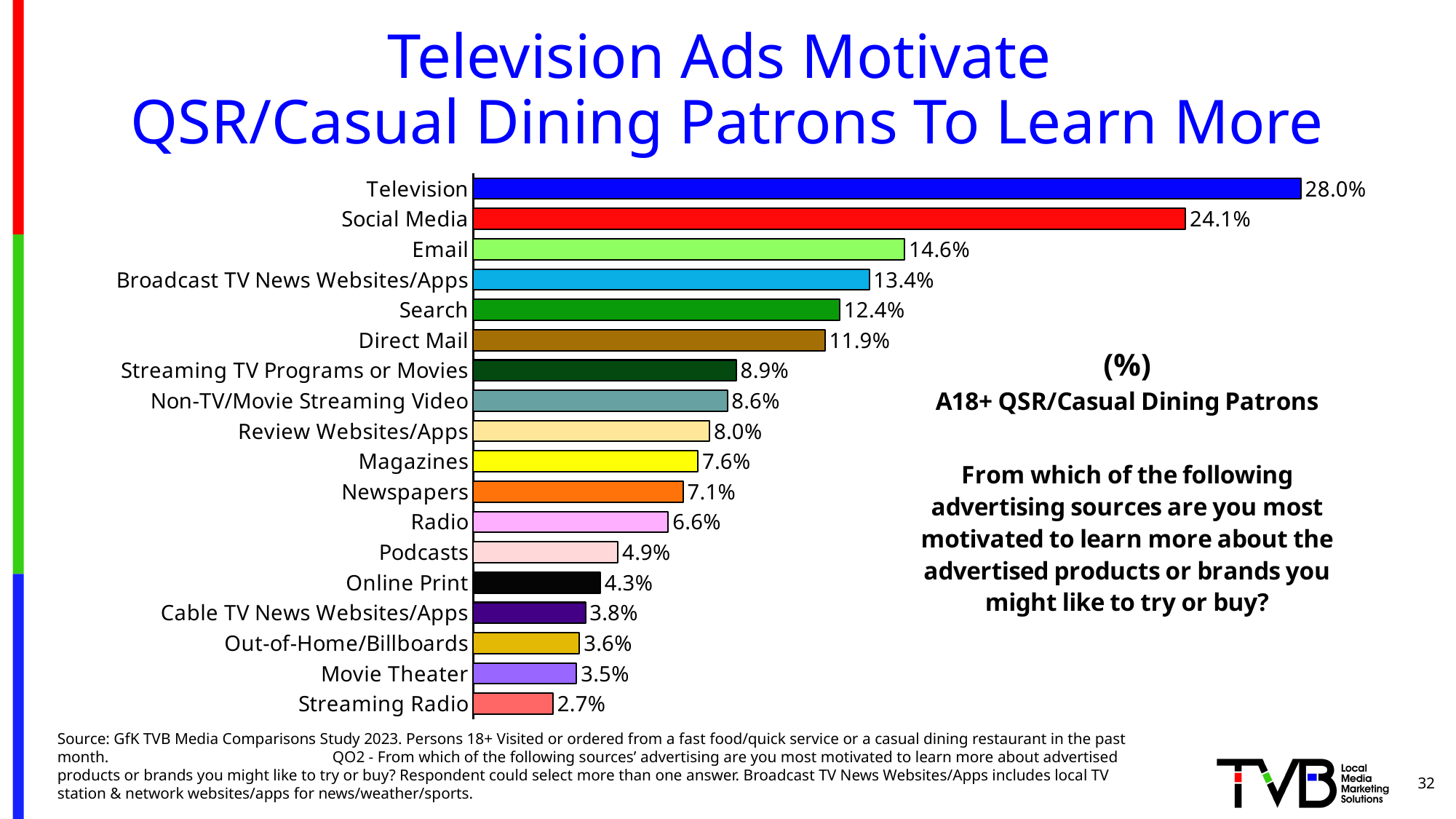
What is the value for Direct Mail? 11.9% What is the difference between the values for Television and Social Media? 3.9% Which is larger, the value for Radio or the value for Review Websites/Apps? Review Websites/Apps What kind of chart is shown on the slide? Bar chart What colour is the bar for Social Media? Red What is the difference between the values for Email and Search? 2.2% What is the value for Television? 28.0% What is the value for Podcasts? 4.9% How many categories are shown in the chart? 18 Which category has the highest value? Television Which category has the lowest value? Streaming Radio Which is larger, the value for Magazines or the value for Newspapers? Magazines